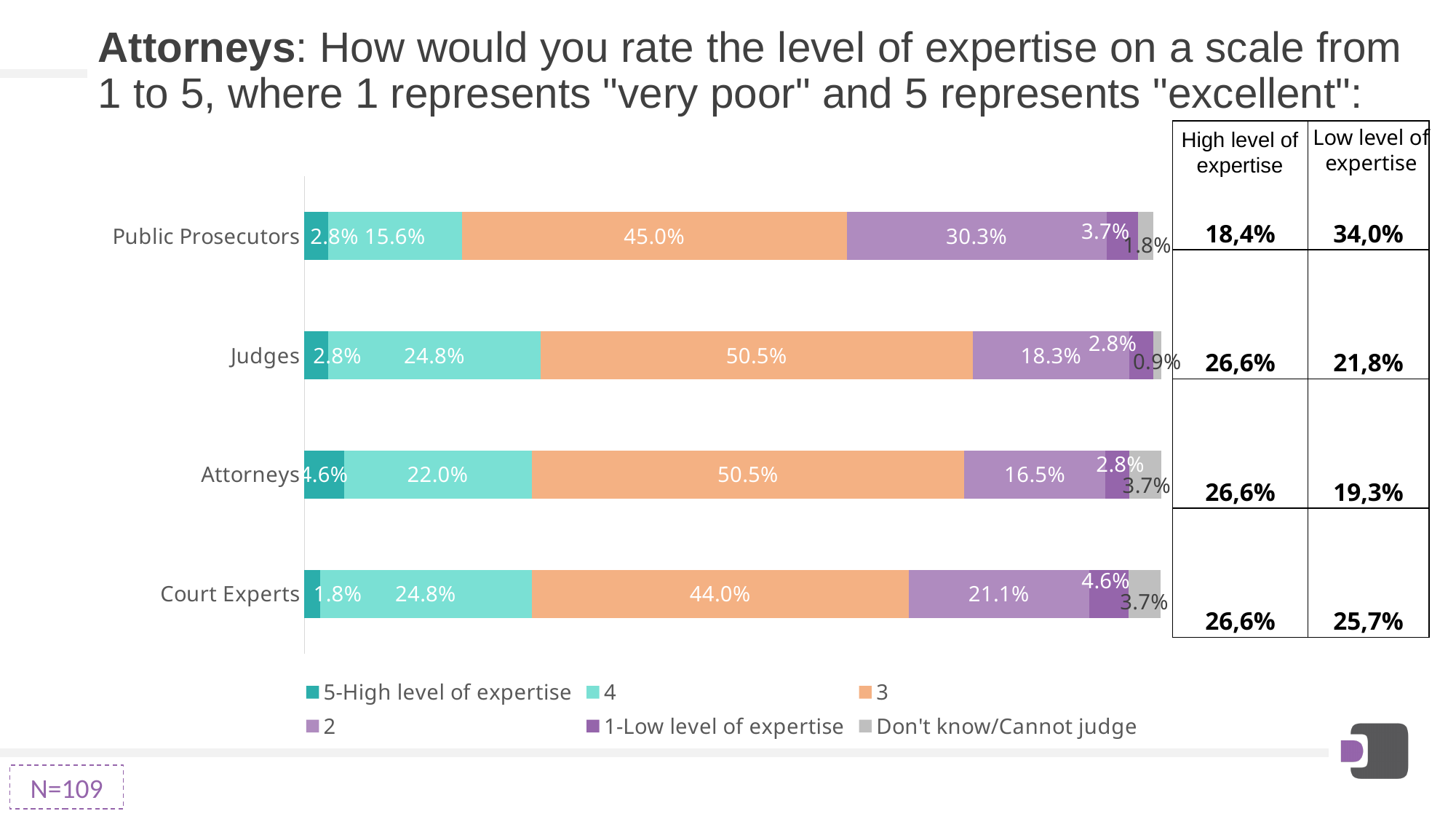
What kind of chart is shown on the slide? Stacked bar chart Which category has the lowest value for '5-High level of expertise'? Court Experts Which category has the highest value for rating 2? Public Prosecutors What percentage of respondents rated Judges with a 4? 24.8% Which is larger: the rating-4 value for Attorneys or for Public Prosecutors? Attorneys What is the difference between the rating-2 value for Public Prosecutors and for Judges? 12.0 percentage points What is the value of '5-High level of expertise' for Attorneys? 4.6% What label does the legend give to the darkest purple series? 1-Low level of expertise How many categories (groups) are plotted on the chart? 4 What is the 'Don't know/Cannot judge' value for Court Experts? 3.7% What percentage of respondents rated Public Prosecutors with a 3? 45.0% How many series does the chart legend list? 6